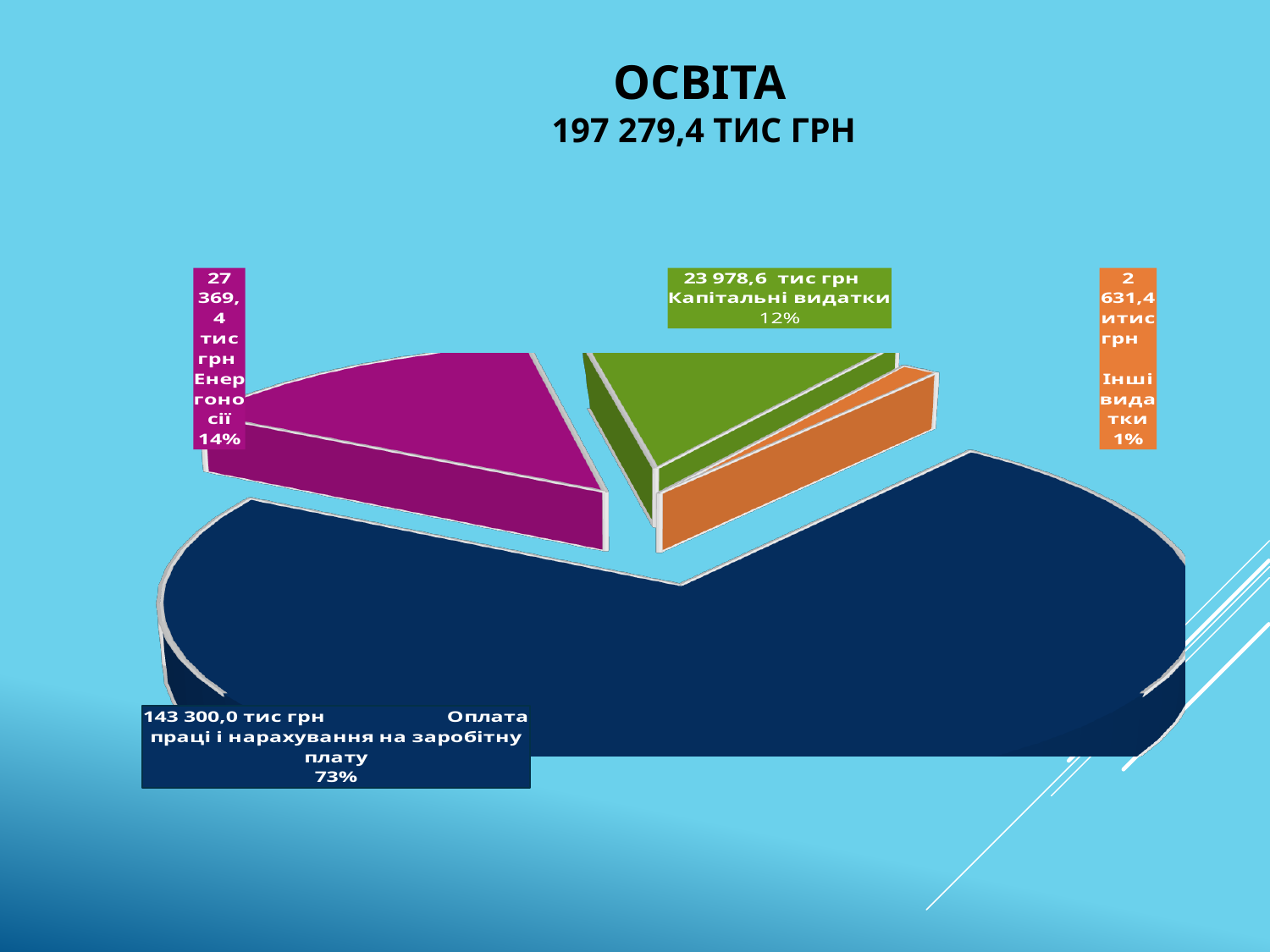
What is the value for Інші видатки? 2 631,4 тис грн How many slices does the pie chart have? 4 What is the value for Енергоносії? 27 369,4 тис грн What is the value for Капітальні видатки? 23 978,6 тис грн What kind of chart is shown on the slide? pie chart Which is larger, Енергоносії or Капітальні видатки? Енергоносії What is the value for Оплата праці і нарахування на заробітну плату? 143 300,0 тис грн Which category has the smallest slice of the pie? Інші видатки What share of the pie does Оплата праці і нарахування на заробітну плату represent? 73% What is the title of the chart on the slide? ОСВІТА 197 279,4 ТИС ГРН Which category has the largest slice of the pie? Оплата праці і нарахування на заробітну плату What share of the pie does Капітальні видатки represent? 12%